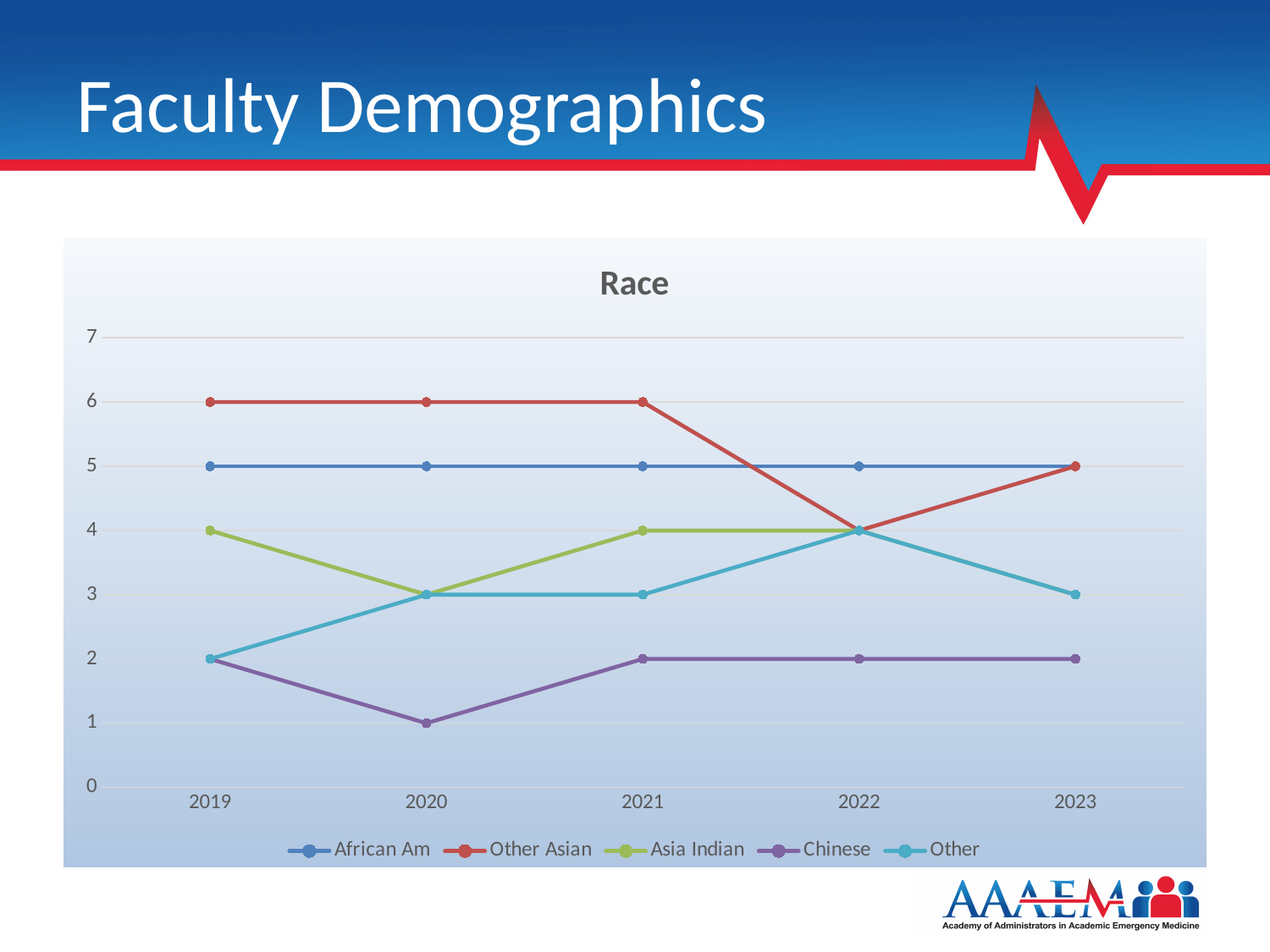
What is the title of the chart? Race How many series does the legend list? 5 Which series has the lowest value in 2023? Chinese What kind of chart is shown on the slide? line chart How many years are shown on the x axis? 5 What is the value for Other Asian in 2019? 6 What is the value for Other in 2022? 4 What is the value for Chinese in 2020? 1 What is the difference between Other Asian and Chinese in 2019? 4 Which is larger in 2020, Asia Indian or Other? They are equal (both 3) Which series has the highest value in 2021? Other Asian Does the African Am series rise, fall, or stay flat from 2019 to 2023? stays flat